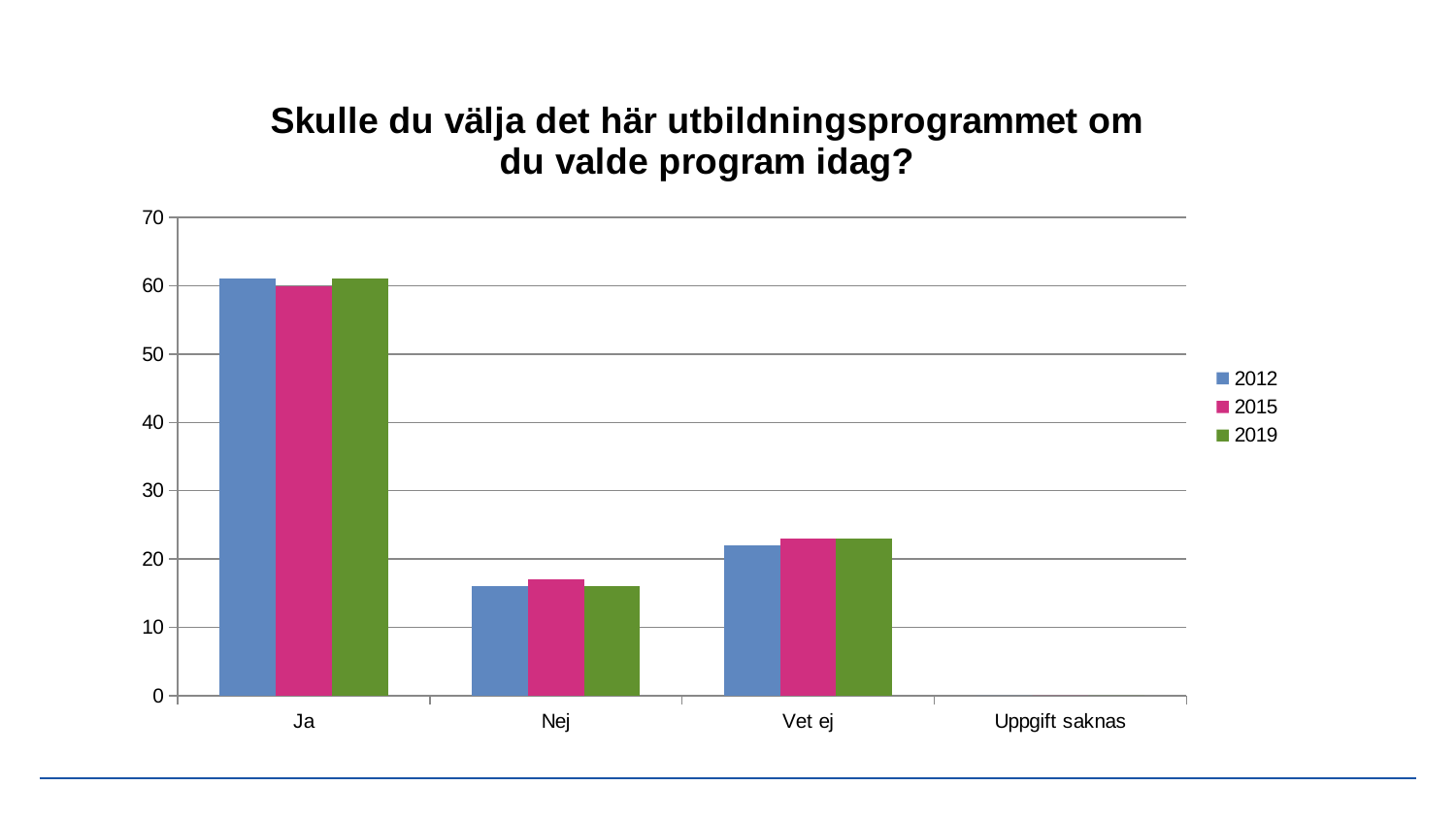
For the 2012 series, which is larger: Ja or Nej? Ja How many categories are shown on the x axis? 4 Which category has the highest value for the 2019 series? Ja Is the value for Ja in 2012 greater or less than 50? greater What kind of chart is shown on the slide? bar chart Which category has the highest value for the 2012 series? Ja Is the value for Vet ej in 2019 greater or less than 20? greater For the 2019 series, which is larger: Nej or Vet ej? Vet ej Is the value for Vet ej in 2012 greater or less than 30? less Which years are listed in the legend? 2012, 2015, 2019 How many series does the legend list? 3